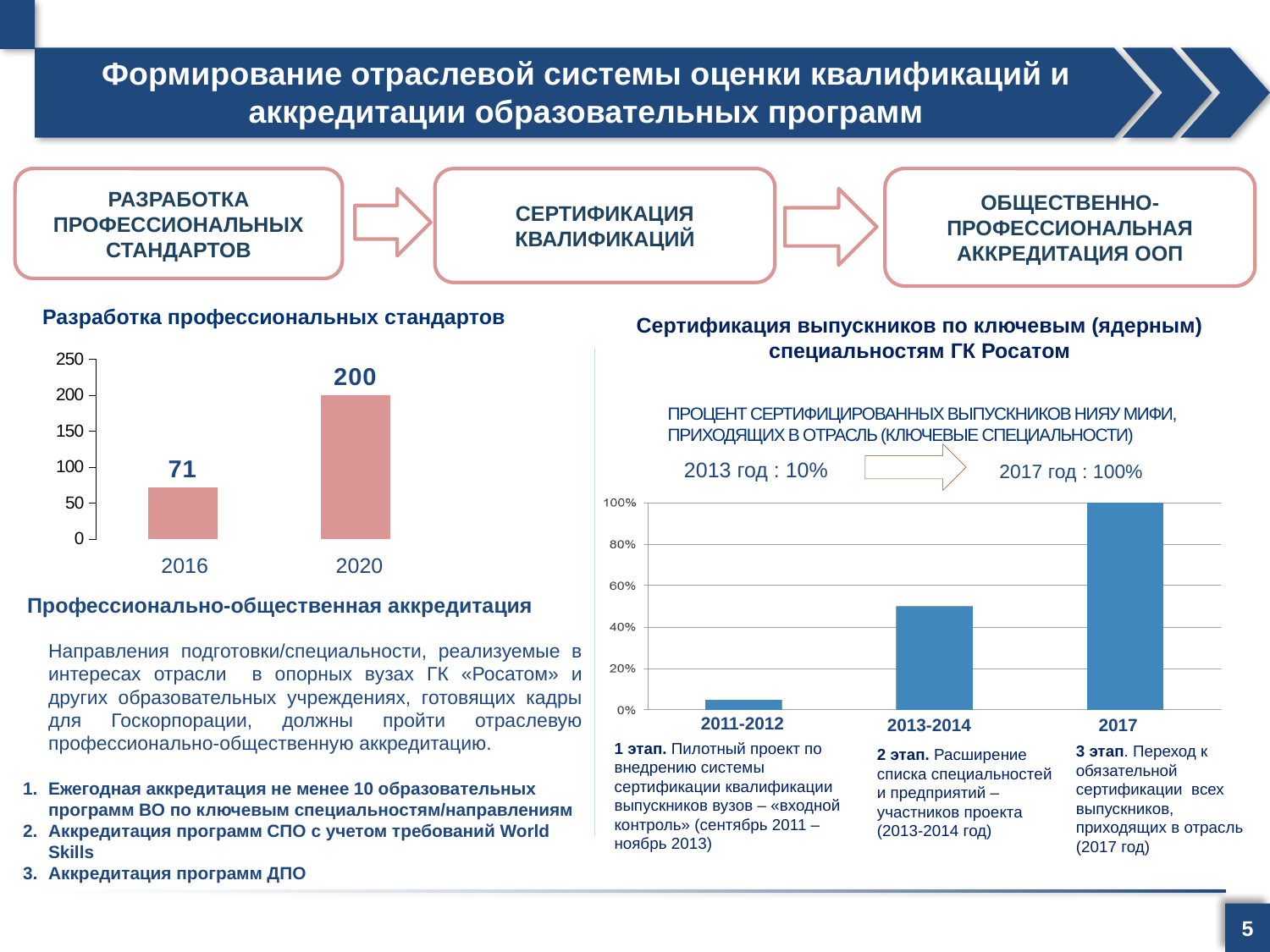
In the left chart 'Разработка профессиональных стандартов', what is the value for 2016? 71 In the right chart on certified graduates, do the values rise or fall from 2011-2012 to 2017? rise In the right chart on certified graduates, is the value for 2013-2014 greater or less than 20%? greater In the right chart on certified graduates, which category has the lowest value? 2011-2012 In the left chart 'Разработка профессиональных стандартов', how many bars are plotted? 2 In the left chart 'Разработка профессиональных стандартов', what is the difference between the 2020 and 2016 values? 129 In the right chart on certified graduates, how many categories are shown on the x axis? 3 In the right chart on certified graduates, what is the value for 2017? 100% In the left chart 'Разработка профессиональных стандартов', which year has the higher value? 2020 What kind of chart is the left chart 'Разработка профессиональных стандартов'? Bar chart In the left chart 'Разработка профессиональных стандартов', is the value for 2016 greater or less than 100? less In the left chart 'Разработка профессиональных стандартов', what is the value for 2020? 200